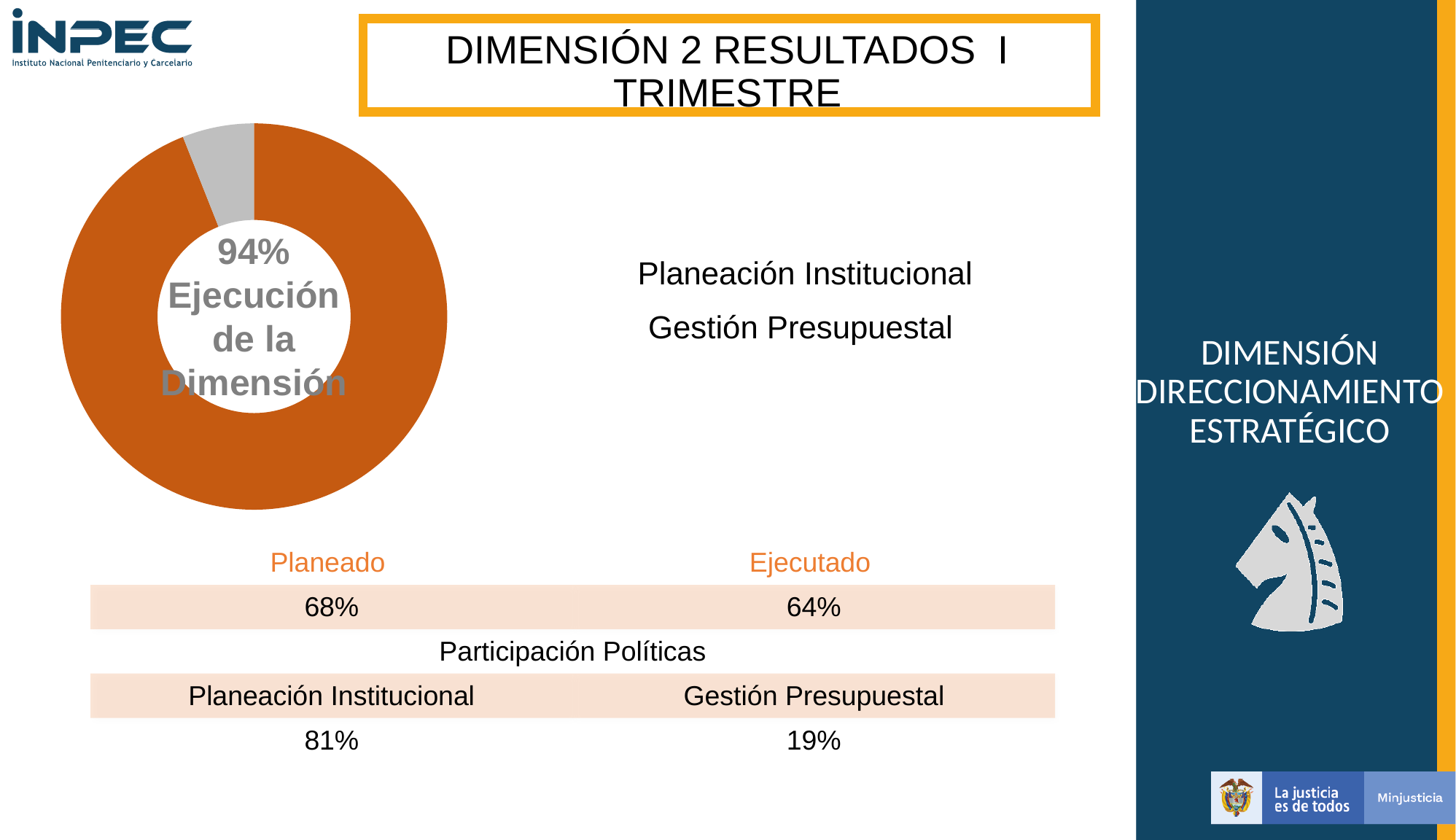
What share of the doughnut chart does the orange slice represent? 94% Which slice of the doughnut chart is larger, the orange one or the grey one? orange What text is written in the centre of the doughnut chart? 94% Ejecución de la Dimensión What kind of chart is shown on the slide? doughnut (pie) chart What percentage is printed in the centre of the doughnut chart? 94% What colour is the largest slice of the doughnut chart? orange How many slices does the doughnut chart have? 2